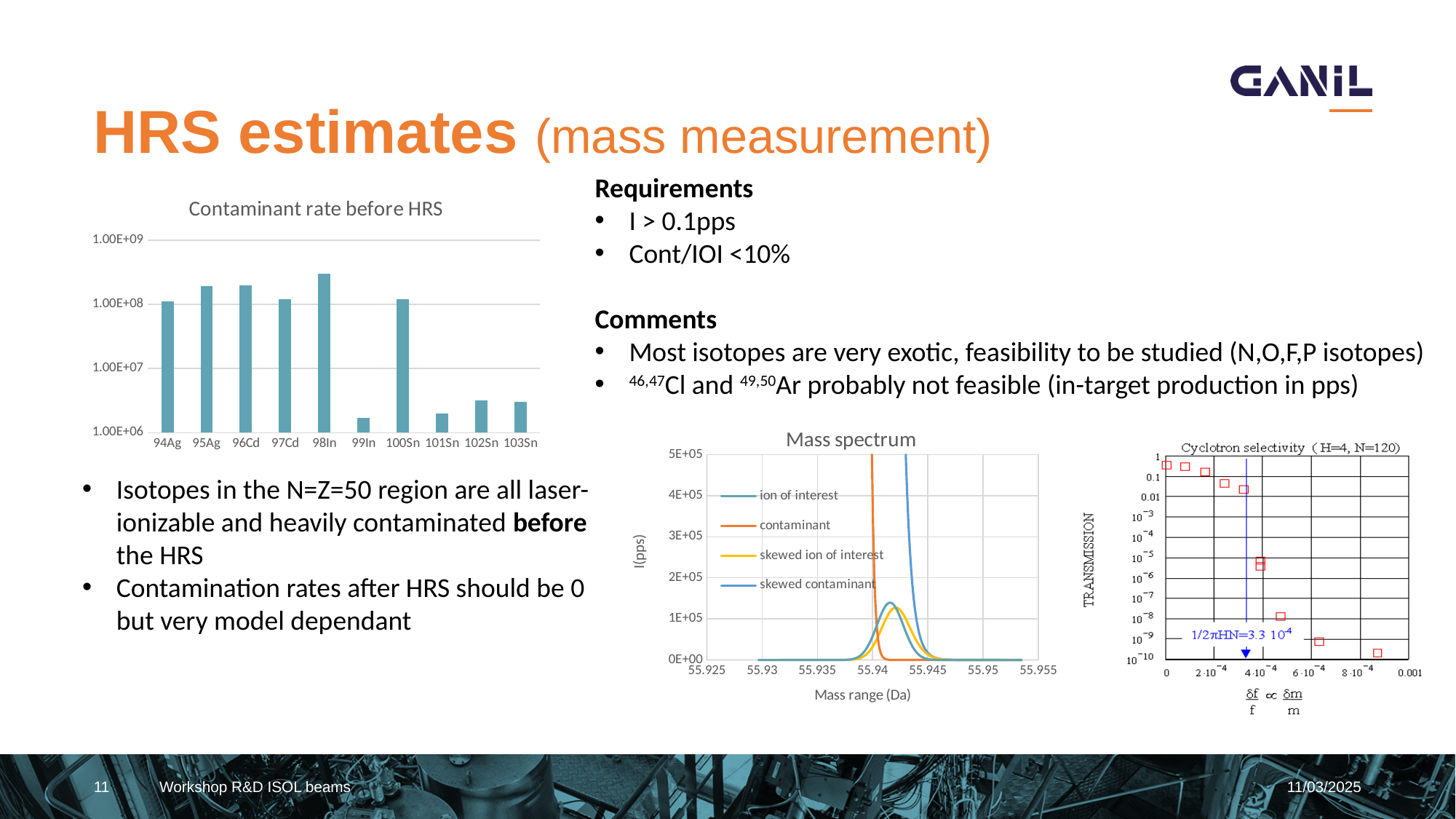
In the 'Contaminant rate before HRS' chart, is the value for 98In greater or less than 1.00E+08? greater In the 'Contaminant rate before HRS' chart, which has the larger contaminant rate, 95Ag or 102Sn? 95Ag In the 'Contaminant rate before HRS' chart, which isotope has the highest contaminant rate? 98In What kind of chart is the 'Mass spectrum' chart? line chart What is the x-axis label of the 'Mass spectrum' chart? Mass range (Da) In the 'Contaminant rate before HRS' chart, is the value for 99In greater or less than 1.00E+07? less What is the y-axis label of the 'Cyclotron selectivity' chart? TRANSMISSION In the 'Contaminant rate before HRS' chart, is the value for 95Ag greater or less than 1.00E+08? greater How many series does the legend of the 'Mass spectrum' chart list? 4 What kind of chart is 'Contaminant rate before HRS'? bar chart In the 'Contaminant rate before HRS' chart, how many isotopes are shown on the x axis? 10 In the 'Contaminant rate before HRS' chart, which has the larger contaminant rate, 98In or 100Sn? 98In